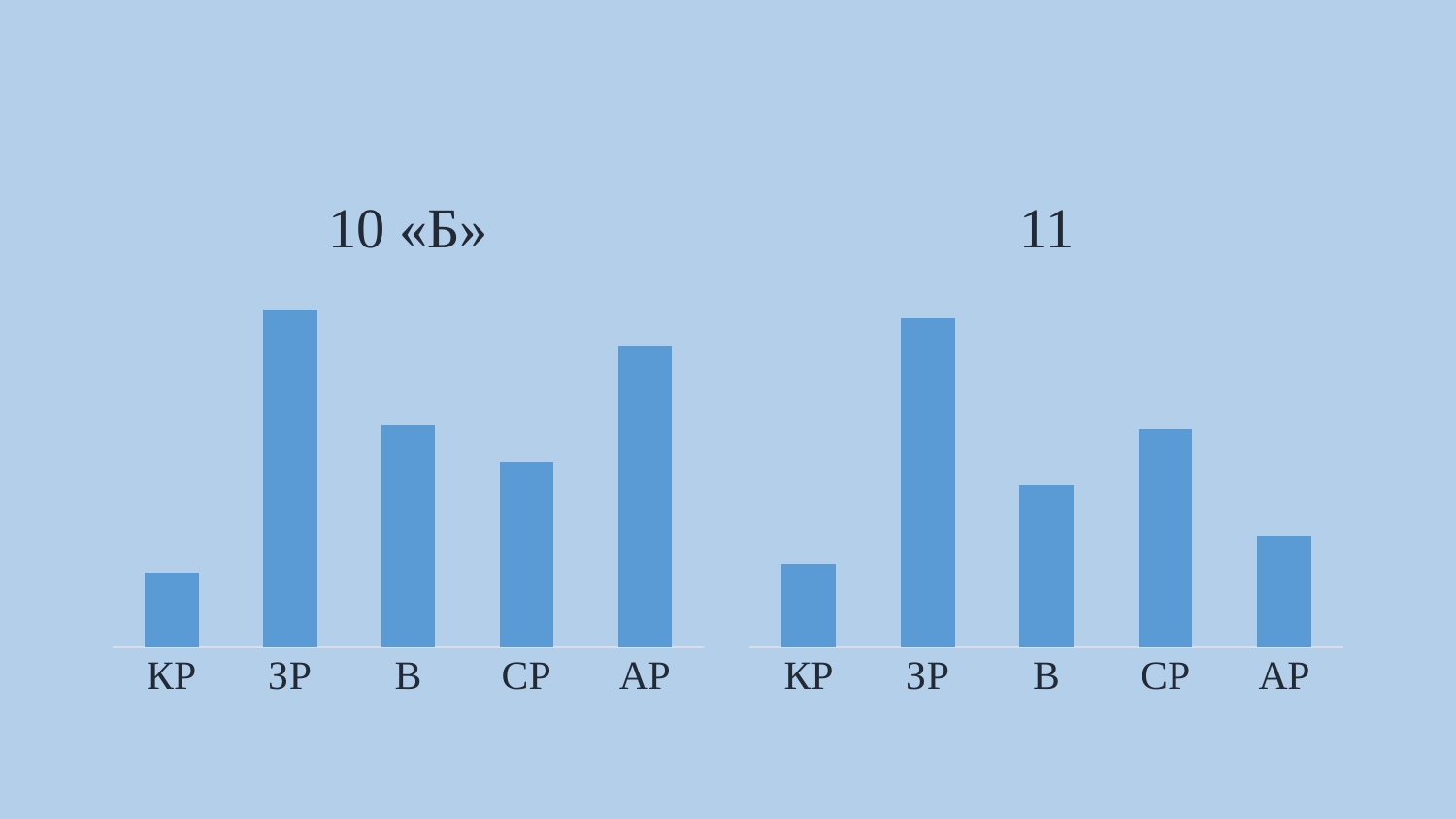
In the chart titled "10 «Б»", which is larger, the bar for В or the bar for СР? В In the chart titled "11", which category has the lowest bar? КР In the chart titled "11", which is larger, the bar for В or the bar for АР? В What is the title of the chart on the left side of the slide? 10 «Б» In the chart titled "10 «Б»", which category has the highest bar? ЗР In the chart titled "10 «Б»", which category has the lowest bar? КР How many categories are shown on the x axis of the chart titled "11"? 5 In the chart titled "10 «Б»", which is larger, the bar for АР or the bar for В? АР What is the title of the chart on the right side of the slide? 11 In the chart titled "11", which category has the highest bar? ЗР What kind of chart is the chart titled "10 «Б»"? Bar chart